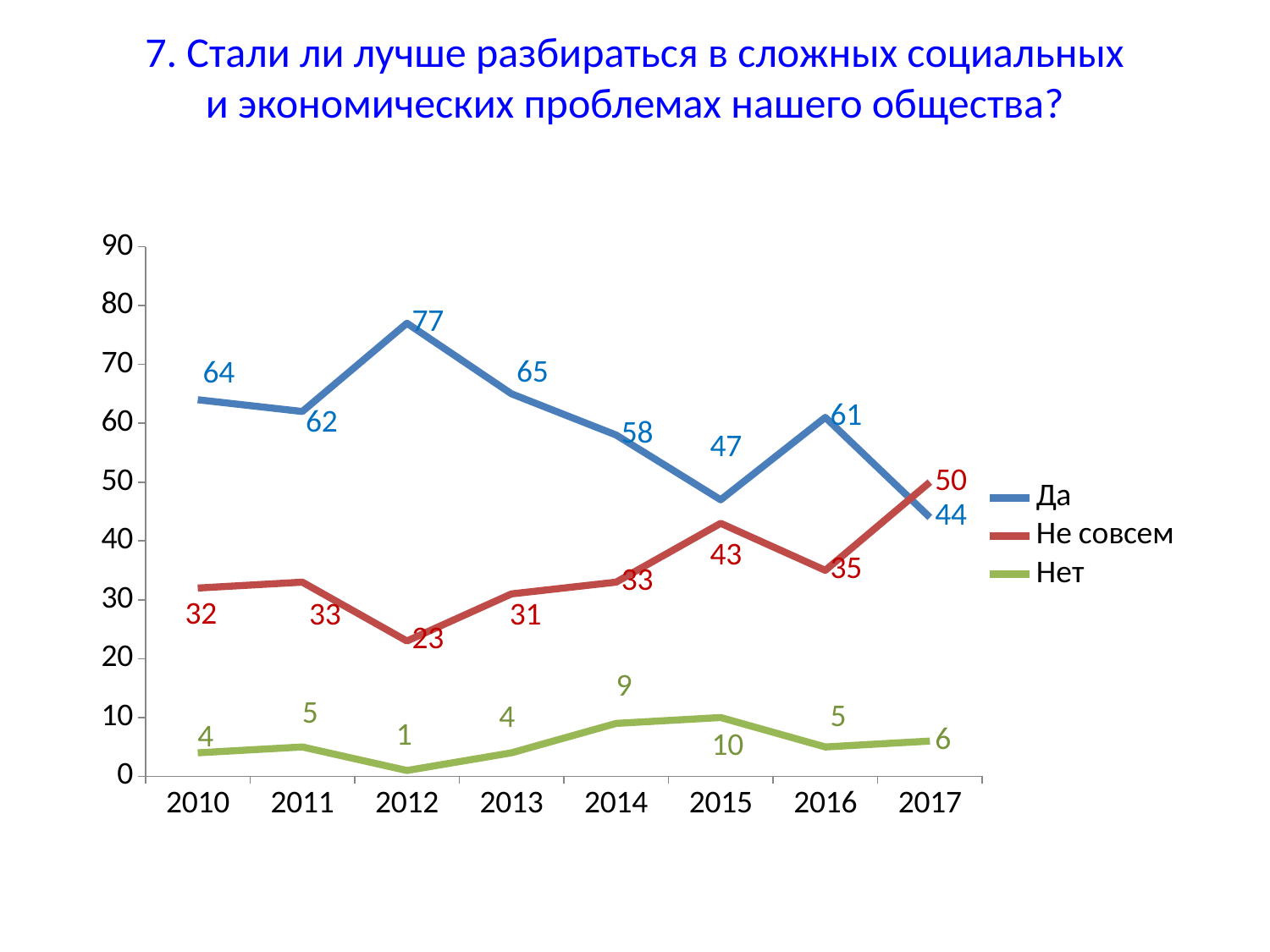
How many years are shown on the x axis? 8 Which is larger in 2017: the value for "Да" or the value for "Не совсем"? Не совсем What kind of chart is shown on the slide? line chart Is the value for "Не совсем" in 2012 greater or less than 30? less In which year does the "Да" series reach its highest value? 2012 What is the difference between the "Да" value in 2012 and the "Да" value in 2017? 33 How many series does the legend list? 3 Does the "Не совсем" series rise or fall from 2015 to 2016? fall What is the value for "Нет" in 2015? 10 In which year does the "Нет" series have its lowest value? 2012 What is the value for "Не совсем" in 2017? 50 What is the value for "Да" in 2012? 77